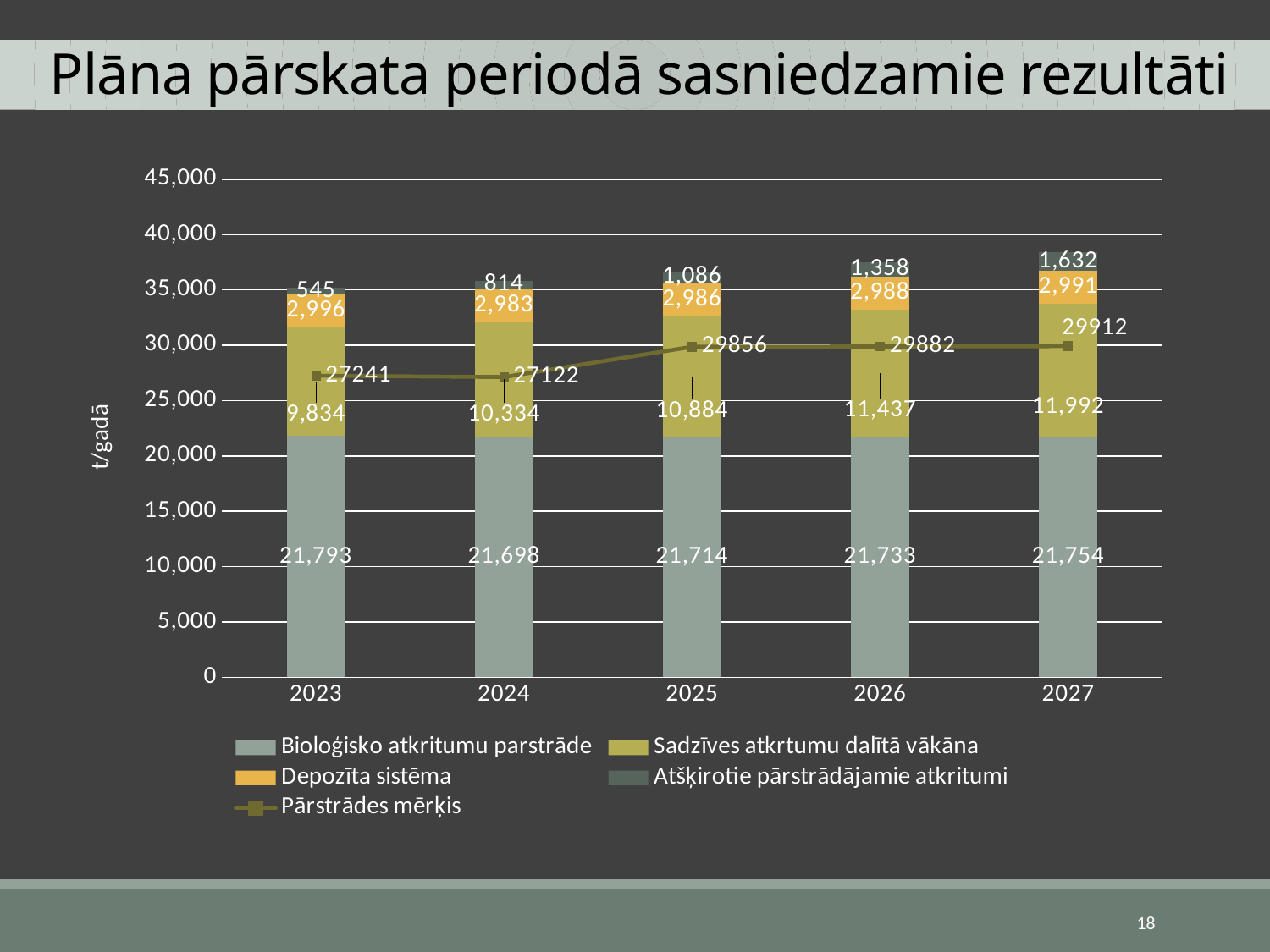
How much larger is Sadzīves atkrtumu dalītā vākāna in 2027 than in 2023? 2,158 Which year has the larger Depozīta sistēma value, 2023 or 2024? 2023 What is the total of the stacked bar for 2027? 38,369 What is the Pārstrādes mērķis value for 2025? 29856 How many series does the legend list? 5 Does Sadzīves atkrtumu dalītā vākāna rise or fall from 2023 to 2027? Rise In which year is the Pārstrādes mērķis line lowest? 2024 What is the value of Atšķirotie pārstrādājamie atkritumi in 2026? 1,358 What kind of chart is shown on the slide? Stacked bar chart with a line How many years are shown on the x axis? 5 What is the value of Bioloģisko atkritumu parstrāde in 2023? 21,793 In which year is Atšķirotie pārstrādājamie atkritumi highest? 2027